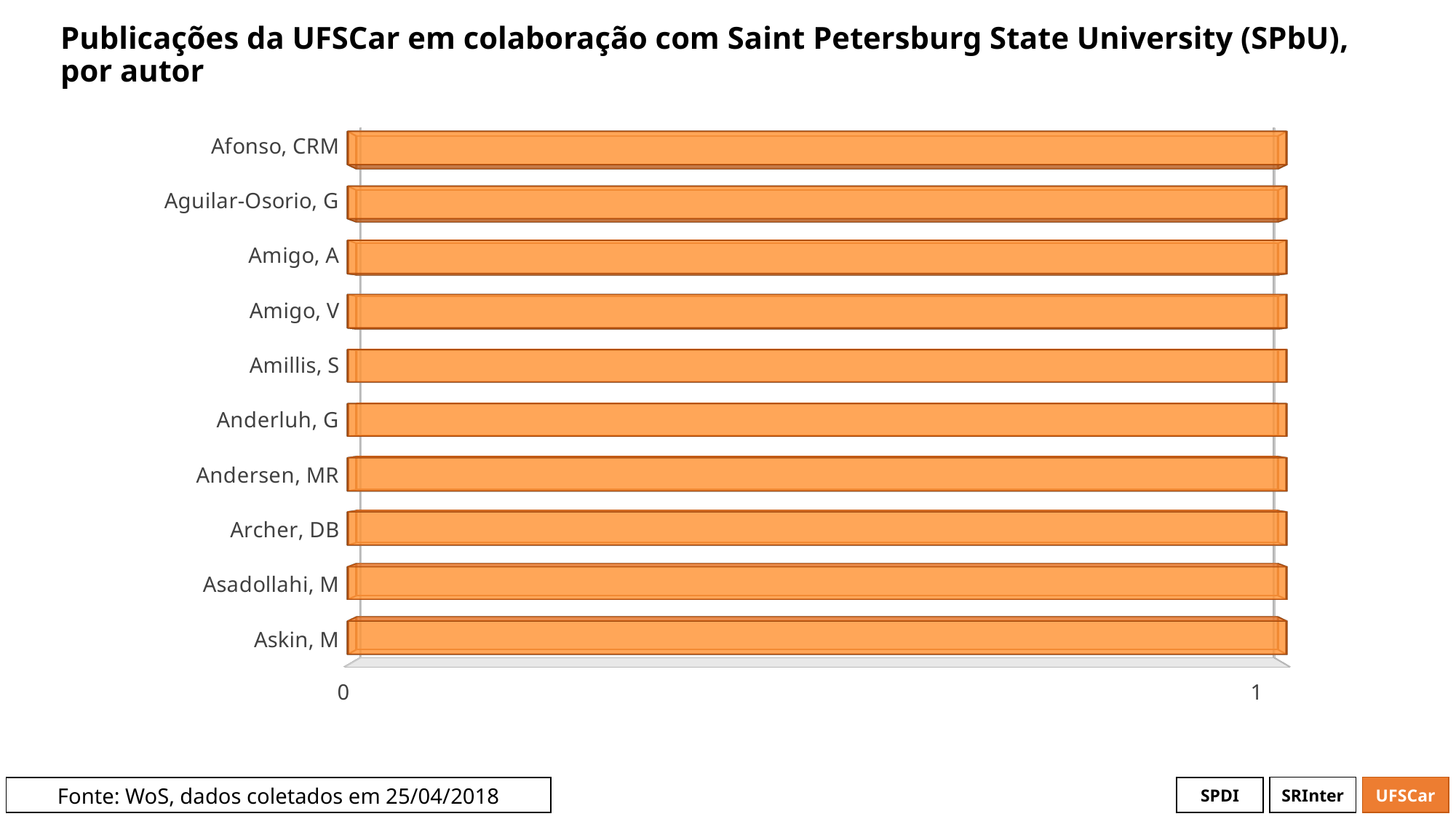
Do the values vary from author to author along the chart? no, all are 1 Which author is listed last (at the bottom) of the chart? Askin, M Which author is listed first (at the top) of the chart? Afonso, CRM What is the highest value shown on the horizontal axis? 1 What colour are the bars in the chart? orange Is the value for Aguilar-Osorio, G larger than, smaller than, or equal to the value for Asadollahi, M? equal How many authors are shown on the chart? 10 What kind of chart is shown on the slide? bar chart What is the value for Askin, M? 1 What is the difference between the values for Amigo, A and Archer, DB? 0 What is the value for Anderluh, G? 1 What is the value for Afonso, CRM? 1